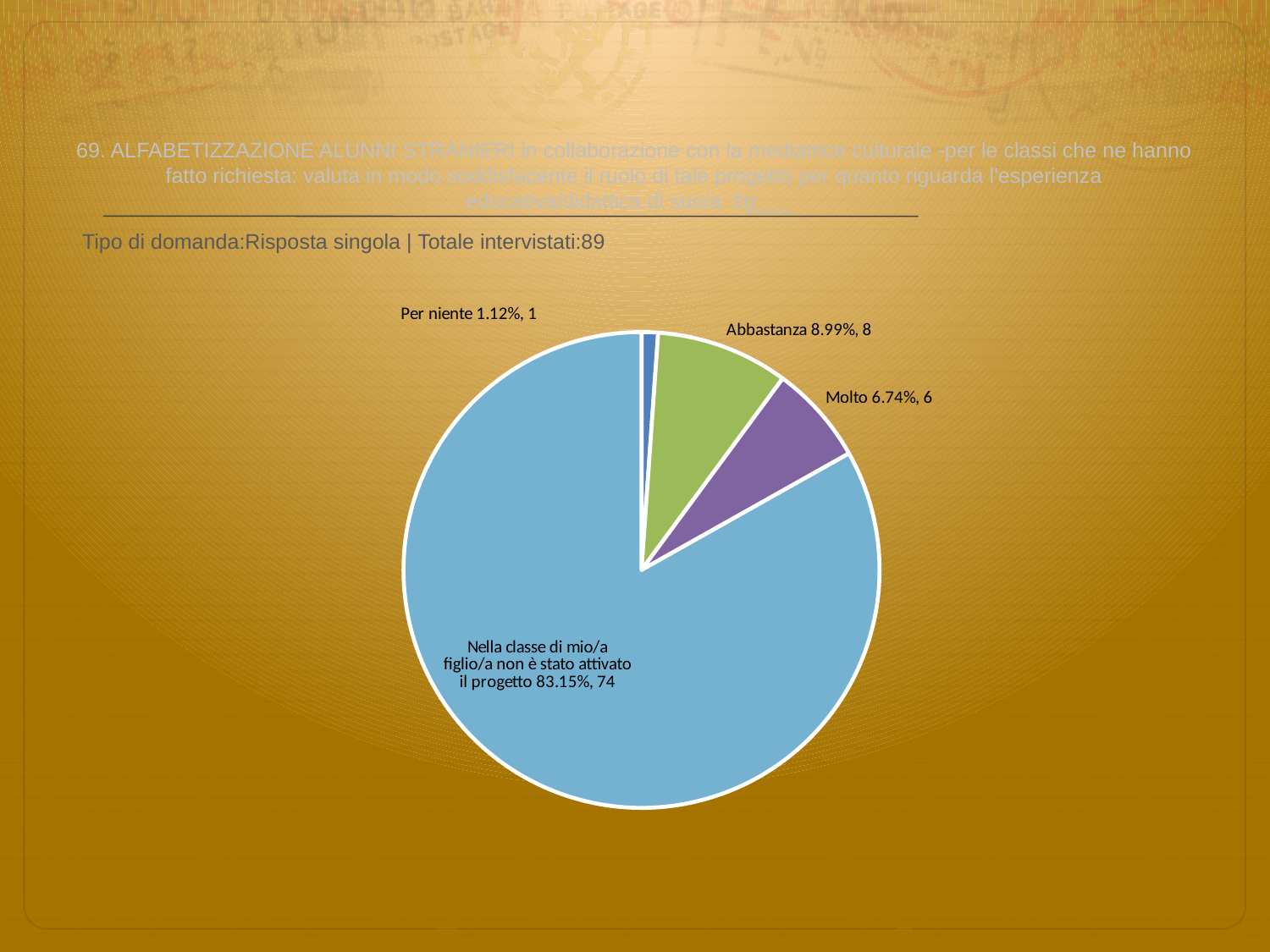
What colour is the 'Molto' slice? purple Which category has the largest slice? Nella classe di mio/a figlio/a non è stato attivato il progetto What kind of chart is shown on the slide? pie chart How many slices does the pie chart have? 4 Which has more respondents, 'Abbastanza' or 'Molto'? Abbastanza How many respondents chose 'Molto'? 6 What percentage share does the 'Nella classe di mio/a figlio/a non è stato attivato il progetto' slice have? 83.15% What percentage share does the 'Abbastanza' slice have? 8.99% Which category has the smallest slice? Per niente What is the total number of respondents (Totale intervistati) stated on the slide? 89 What is the difference in number of respondents between 'Abbastanza' and 'Molto'? 2 How many respondents chose 'Per niente'? 1